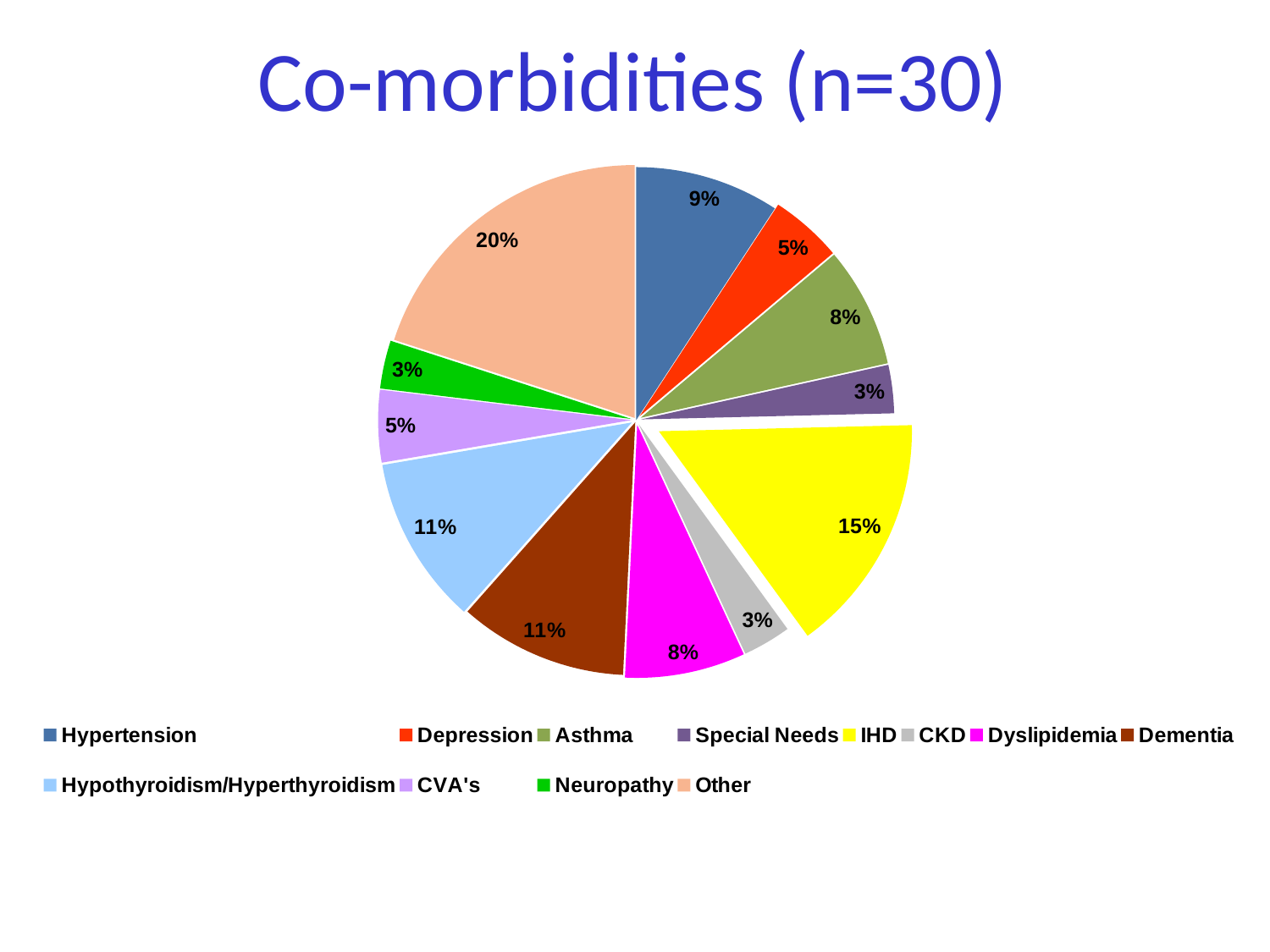
Which category has the largest slice of the pie? Other How many categories does the legend list? 12 What is the title of the chart? Co-morbidities (n=30) What share of the pie is Hypertension? 9% What share of the pie is Other? 20% Which is larger, the share for Depression or the share for Asthma? Asthma What colour is the IHD slice? Yellow What is the difference between the shares for Other and IHD? 5% What kind of chart is shown on the slide? Pie chart What share of the pie is Dementia? 11%